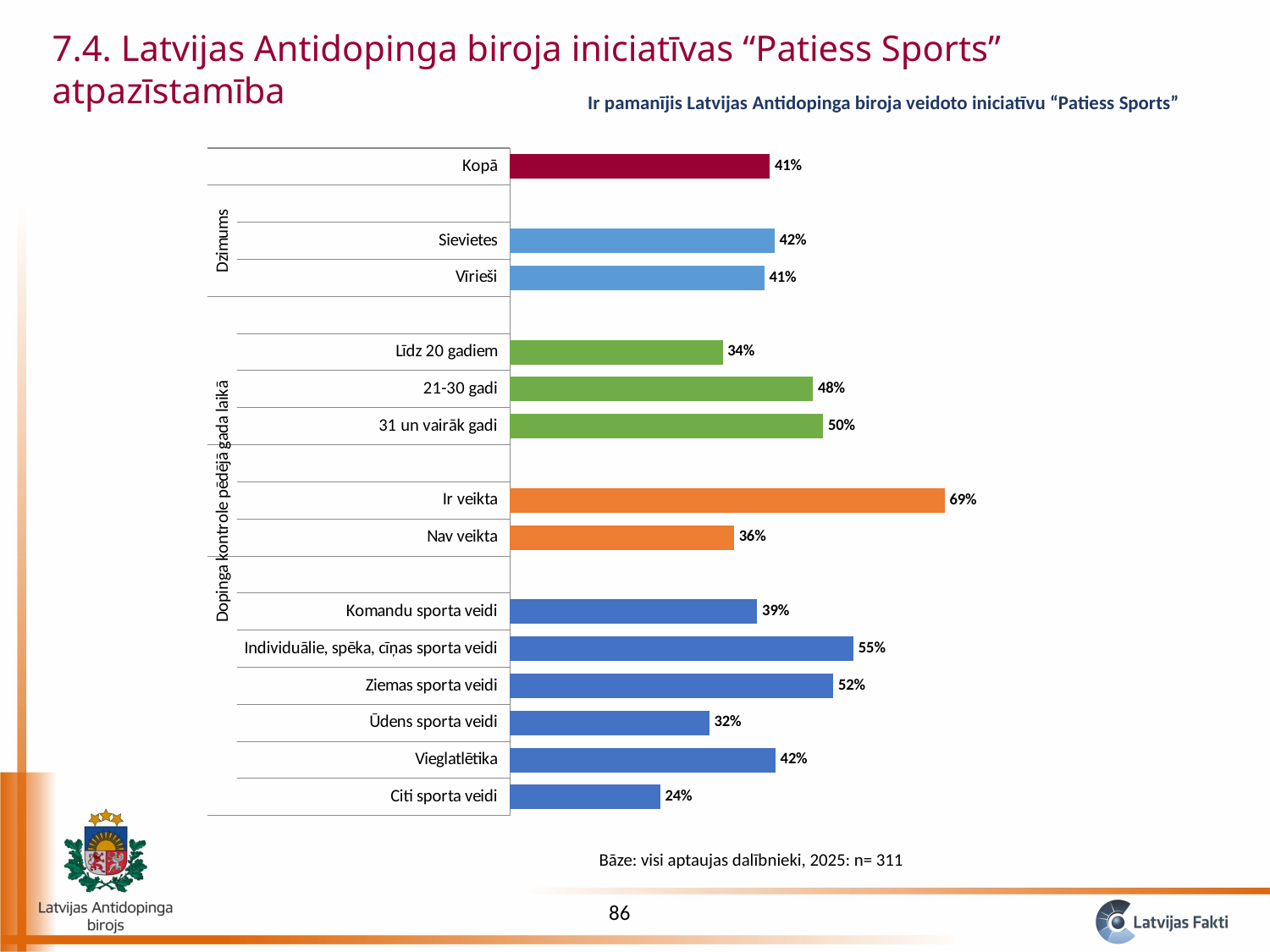
What is the value for Kopā? 41% Which category has the highest value? Ir veikta How many bars are plotted in the chart? 14 What is the value for 21-30 gadi? 48% What is the title of the chart? Ir pamanījis Latvijas Antidopinga biroja veidoto iniciatīvu “Patiess Sports” What is the value for Ir veikta? 69% What kind of chart is shown on the slide? Bar chart What is the difference between the values for 31 un vairāk gadi and Līdz 20 gadiem? 16% Which is larger, the value for Individuālie, spēka, cīņas sporta veidi or the value for Ziemas sporta veidi? Individuālie, spēka, cīņas sporta veidi Which category has the lowest value? Citi sporta veidi What is the value for Ūdens sporta veidi? 32% What is the difference between the values for Ir veikta and Nav veikta? 33%